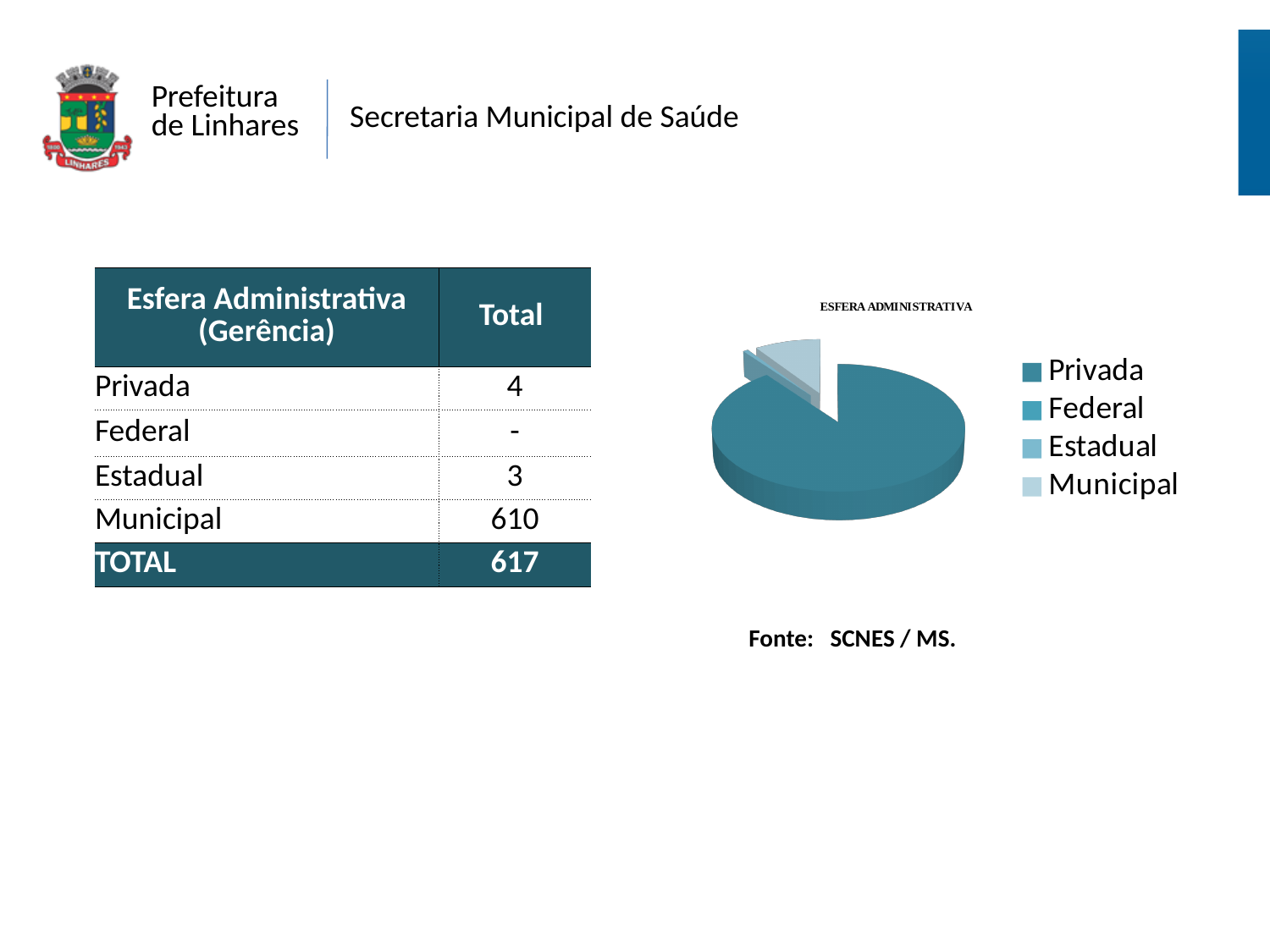
Which esfera administrativa has the highest total? Municipal What is the overall TOTAL shown in the table? 617 What is the total for Estadual in the table? 3 Which is larger, the total for Privada or the total for Estadual? Privada How many categories (esferas administrativas) are shown in the table and chart? 4 What is the title of the pie chart? ESFERA ADMINISTRATIVA What is the total for Municipal in the table? 610 What is the difference between the Municipal total and the Privada total? 606 What kind of chart is shown on the slide? pie chart How many entries does the legend of the pie chart list? 4 What is the total for Privada in the table? 4 What value is shown for Federal in the table? -